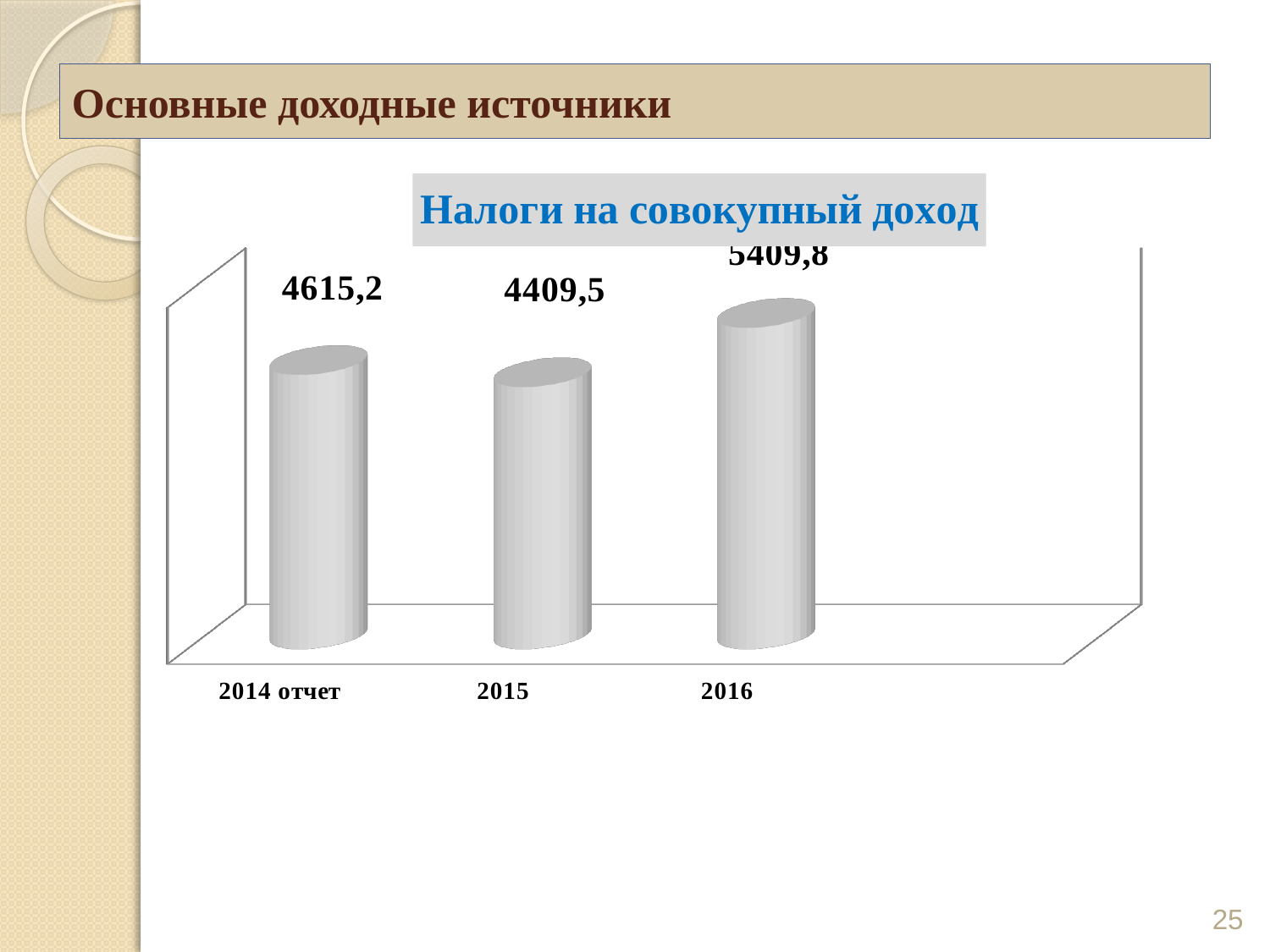
What is the difference between the values for 2014 отчет and 2015? 205,7 What is the value for 2014 отчет? 4615,2 How many categories are shown on the x axis? 3 What is the value for 2015? 4409,5 What kind of chart is shown? bar chart What is the difference between the values for 2016 and 2015? 1000,3 What is the difference between the values for 2016 and 2014 отчет? 794,6 What is the value for 2016? 5409,8 Which year has the lowest value? 2015 What is the title of the chart? Налоги на совокупный доход Which year has the highest value? 2016 Which is larger, the value for 2014 отчет or the value for 2015? 2014 отчет